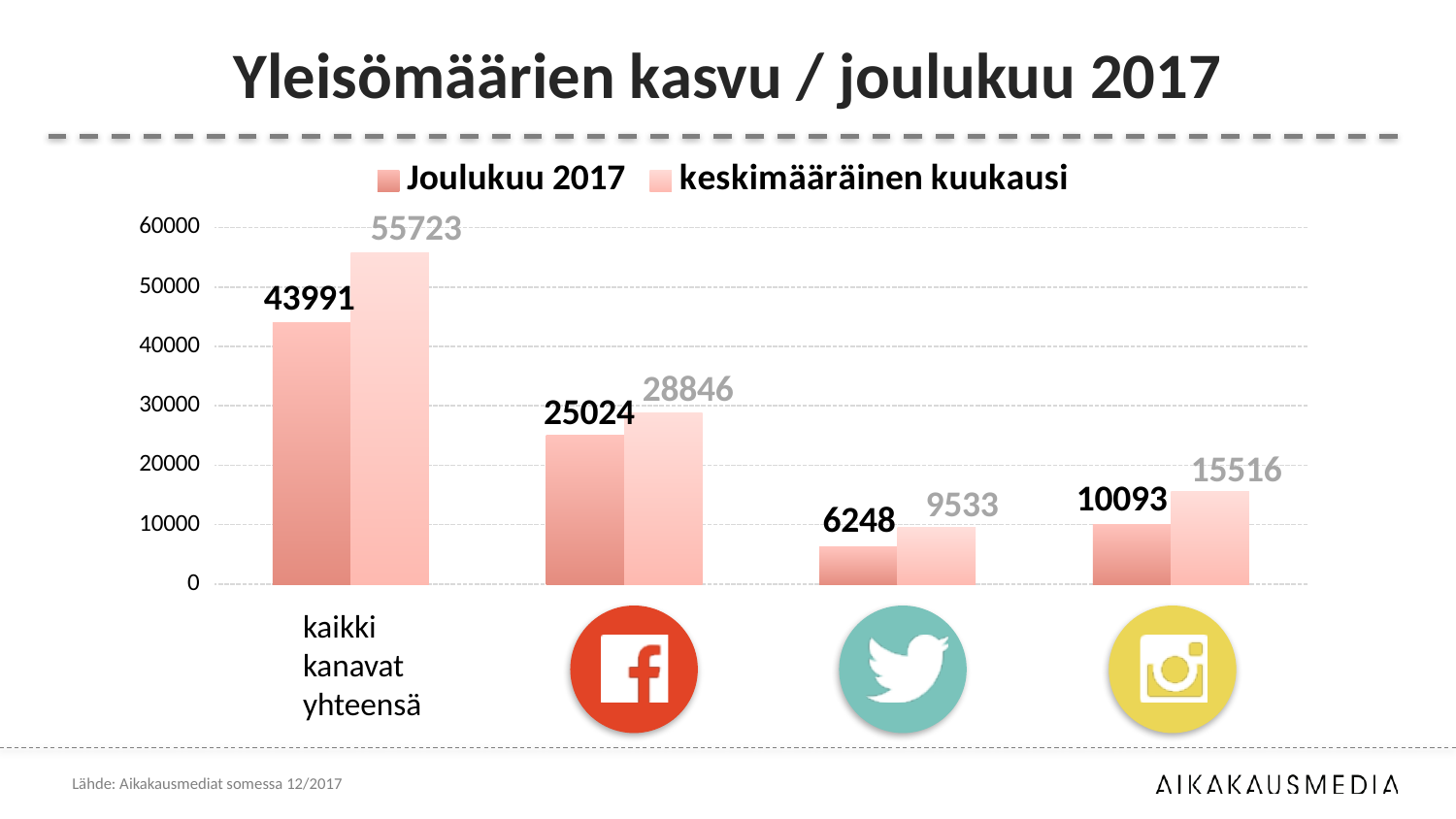
Which category has the lowest Joulukuu 2017 value? the third category (Twitter icon) What is the keskimääräinen kuukausi value for "kaikki kanavat yhteensä"? 55723 What is the keskimääräinen kuukausi value for the third category from the left (Twitter icon)? 9533 What is the Joulukuu 2017 value for the second category from the left (Facebook icon)? 25024 What type of chart is shown on the slide? bar chart For the fourth category from the left (Instagram icon), what is the difference between the keskimääräinen kuukausi value and the Joulukuu 2017 value? 5423 What is the Joulukuu 2017 value for "kaikki kanavat yhteensä"? 43991 How many categories are shown on the x axis? 4 Which has the larger Joulukuu 2017 value: the third category (Twitter icon) or the fourth category (Instagram icon)? the fourth category (Instagram icon) For "kaikki kanavat yhteensä", how much larger is the keskimääräinen kuukausi value than the Joulukuu 2017 value? 11732 What is the Joulukuu 2017 value for the fourth category from the left (Instagram icon)? 10093 How many series does the legend list? 2